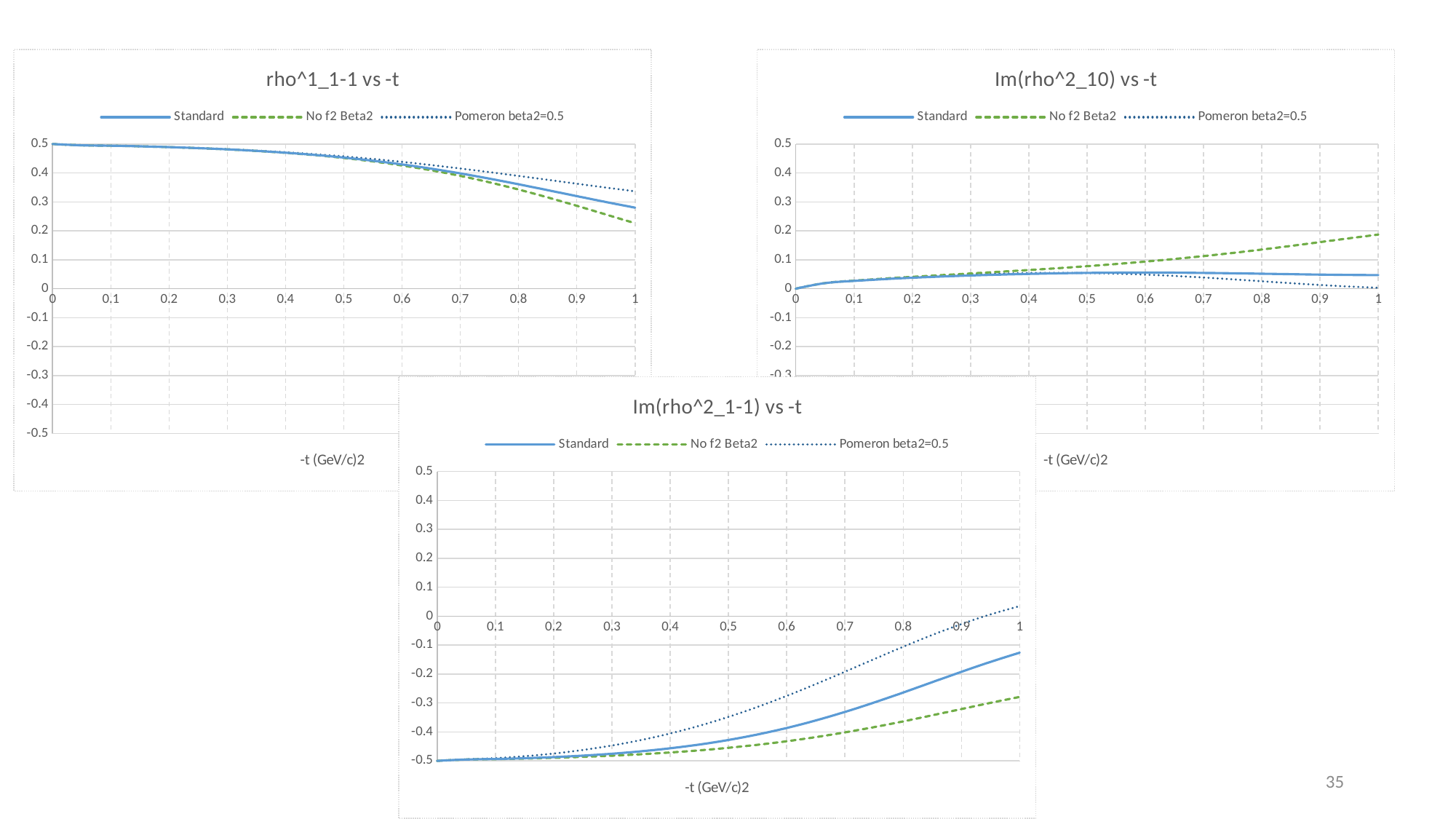
In "rho^1_1-1 vs -t", is the value of the No f2 Beta2 series at -t = 1 greater or less than 0.3? less How many series does the legend of "Im(rho^2_10) vs -t" list? 3 In "rho^1_1-1 vs -t", is the value of the Pomeron beta2=0.5 series at -t = 1 greater or less than 0.3? greater In "Im(rho^2_1-1) vs -t", is the value of the No f2 Beta2 series at -t = 1 greater or less than -0.2? less In "Im(rho^2_1-1) vs -t", which series has the larger value at -t = 1, Pomeron beta2=0.5 or No f2 Beta2? Pomeron beta2=0.5 What is the x-axis label of the chart titled "Im(rho^2_1-1) vs -t"? -t (GeV/c)2 What kind of chart is "rho^1_1-1 vs -t"? line chart In "Im(rho^2_10) vs -t", do the values of the No f2 Beta2 series rise or fall as -t increases from 0 to 1? rise In "rho^1_1-1 vs -t", do the values of the Standard series rise or fall as -t increases from 0 to 1? fall In "Im(rho^2_10) vs -t", which series has the larger value at -t = 1, No f2 Beta2 or Standard? No f2 Beta2 In "Im(rho^2_1-1) vs -t", do the values of the Standard series rise or fall as -t increases from 0 to 1? rise